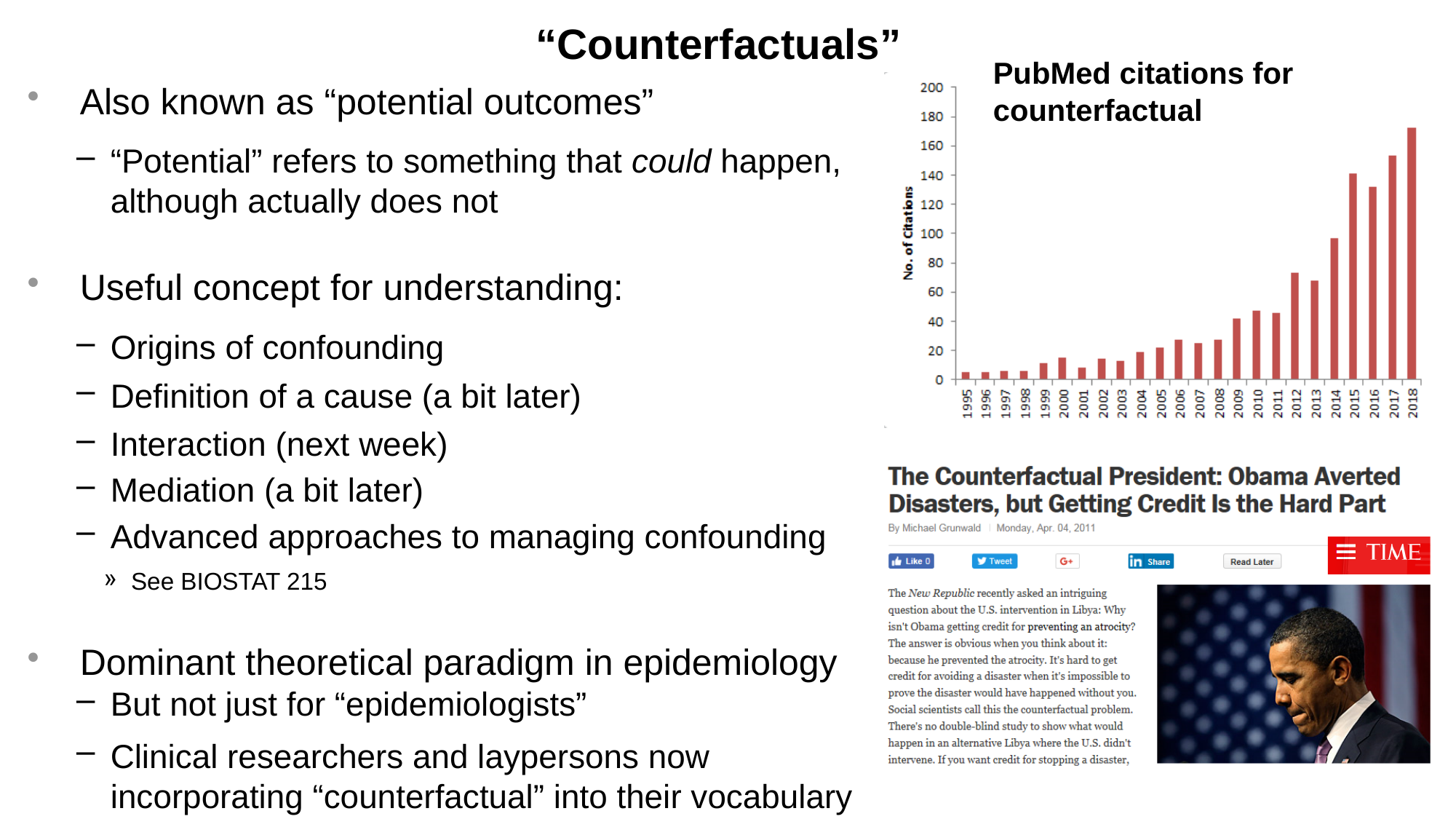
In the PubMed citations for counterfactual chart, is the value for 2009 greater or less than 60? less In the PubMed citations for counterfactual chart, which year has more citations, 2014 or 2012? 2014 Which year has the highest number of citations in the PubMed citations for counterfactual chart? 2018 In the PubMed citations for counterfactual chart, which year has more citations, 2017 or 2016? 2017 How many years are shown on the x axis of the PubMed citations for counterfactual chart? 24 What kind of chart is the PubMed citations for counterfactual chart? bar chart Do the values in the PubMed citations for counterfactual chart generally rise or fall from 1995 to 2018? rise In the PubMed citations for counterfactual chart, is the value for 2012 greater or less than 60? greater What is the label on the y axis of the PubMed citations for counterfactual chart? No. of Citations In the PubMed citations for counterfactual chart, is the value for 2018 greater or less than 160? greater